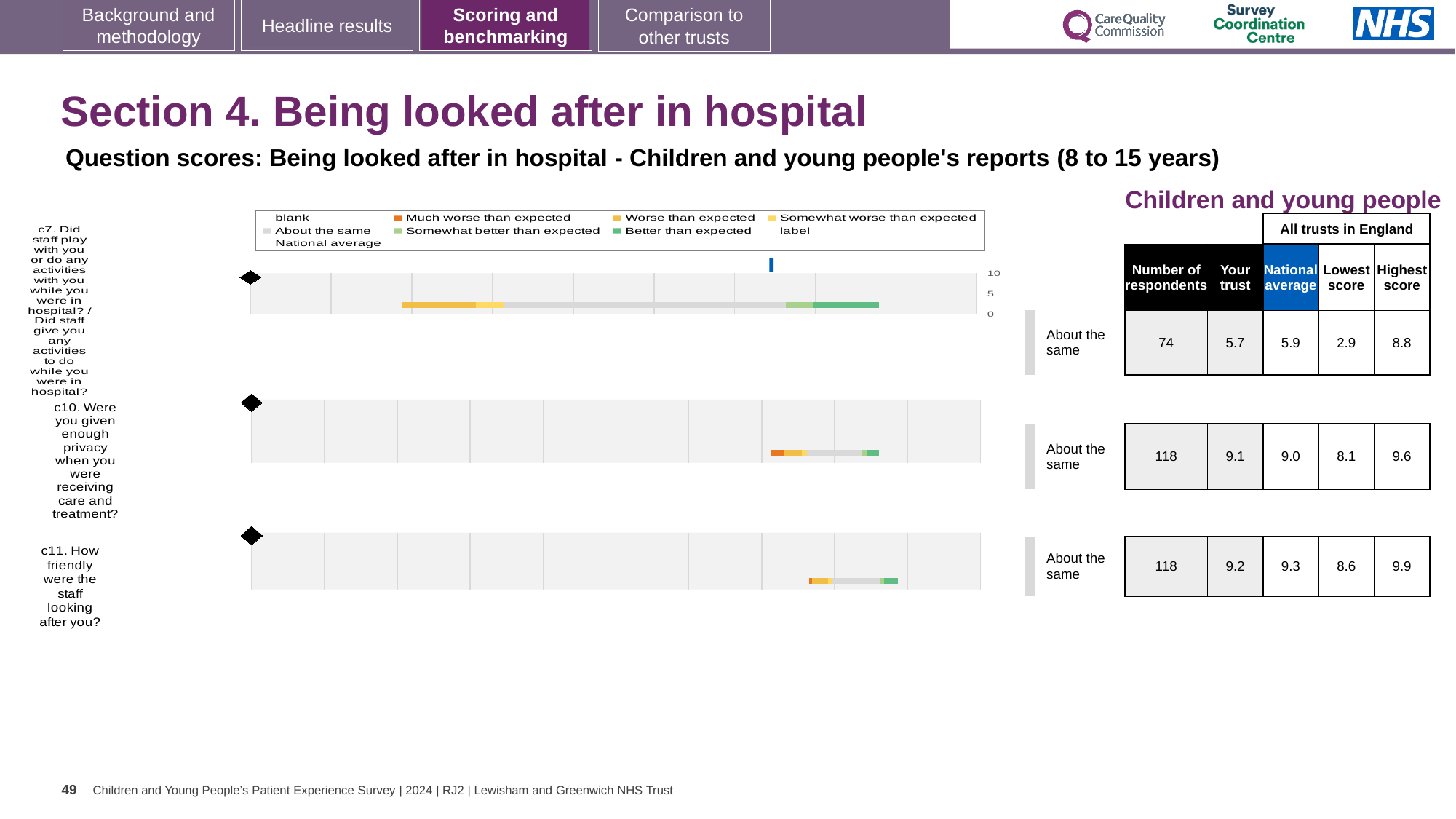
Which question has the highest 'Your trust' score? c11. How friendly were the staff looking after you? What is the national average score for c11 (How friendly were the staff looking after you?)? 9.3 What kind of chart is used to show the question scores on this slide? bar chart For c7, what is the difference between the highest score and the lowest score across all trusts in England? 5.9 For c10, which is larger: the 'Your trust' score or the national average? Your trust How many respondents answered question c7 (Did staff play with you or do any activities with you while you were in hospital?)? 74 Is the 'Your trust' score for c7 greater or less than 5? greater How many questions (chart rows) are plotted on the slide? 3 What is the lowest score across all trusts in England for c10? 8.1 Which question has the lowest 'Your trust' score? c7. Did staff play with you or do any activities with you while you were in hospital? What is the 'Your trust' score for c10 (Were you given enough privacy when you were receiving care and treatment?)? 9.1 What benchmark category is shown for c7 (Did staff play with you or do any activities with you while you were in hospital?)? About the same